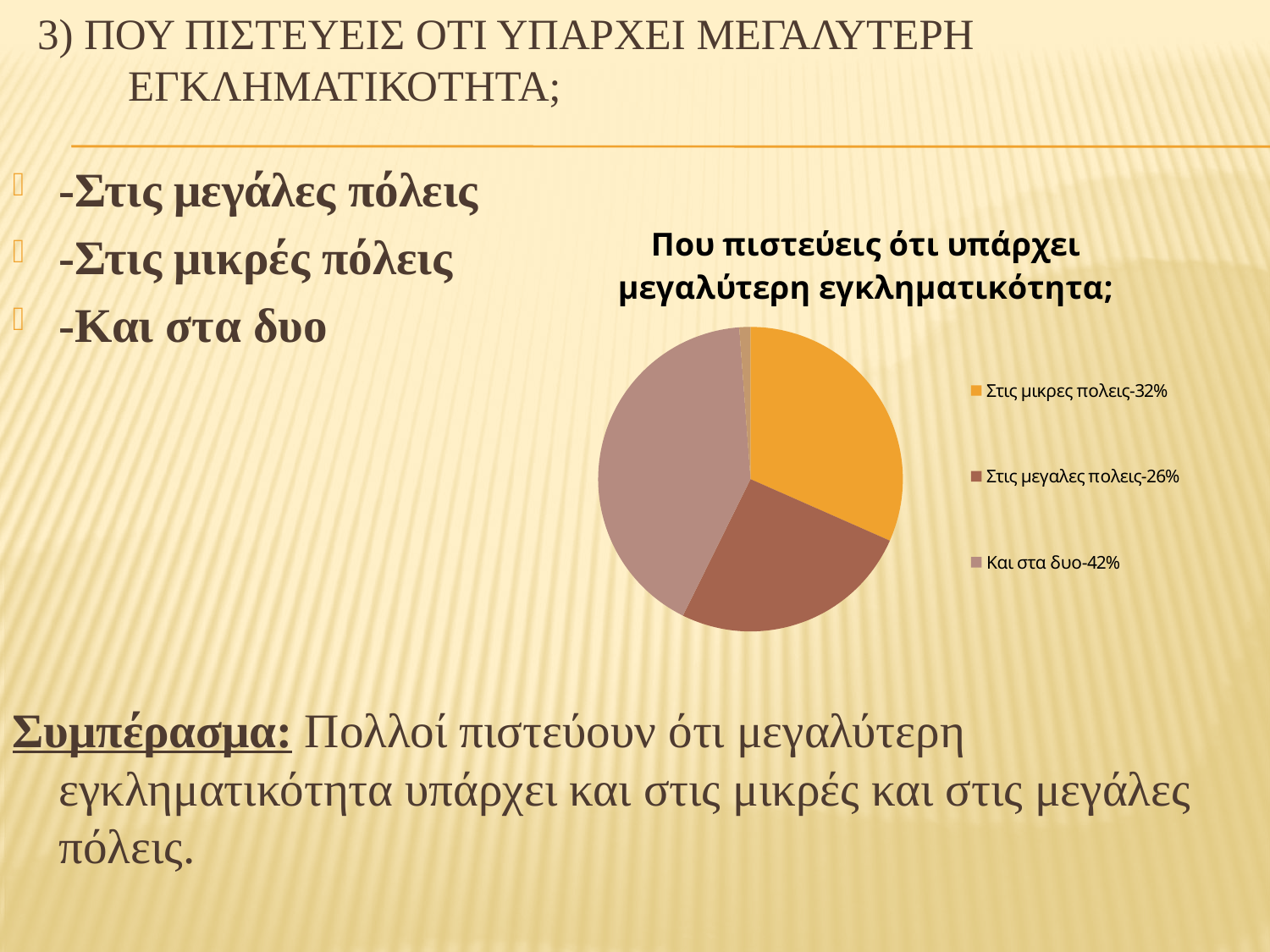
What is the chart's title? Που πιστεύεις ότι υπάρχει μεγαλύτερη εγκληματικότητα; What percentage is shown for 'Στις μικρες πολεις'? 32% Which category has the smallest share of the pie among the legend entries? Στις μεγαλες πολεις How many entries does the legend list? 3 What percentage is shown for 'Και στα δυο'? 42% What is the difference in percentage points between 'Στις μικρες πολεις' and 'Στις μεγαλες πολεις'? 6 What percentage is shown for 'Στις μεγαλες πολεις'? 26% What colour is the slice for 'Και στα δυο'? mauve/greyish pink What is the difference in percentage points between 'Και στα δυο' and 'Στις μεγαλες πολεις'? 16 Which is larger, the share for 'Στις μικρες πολεις' or for 'Στις μεγαλες πολεις'? Στις μικρες πολεις Which category has the largest share of the pie? Και στα δυο What kind of chart is shown on the slide? pie chart